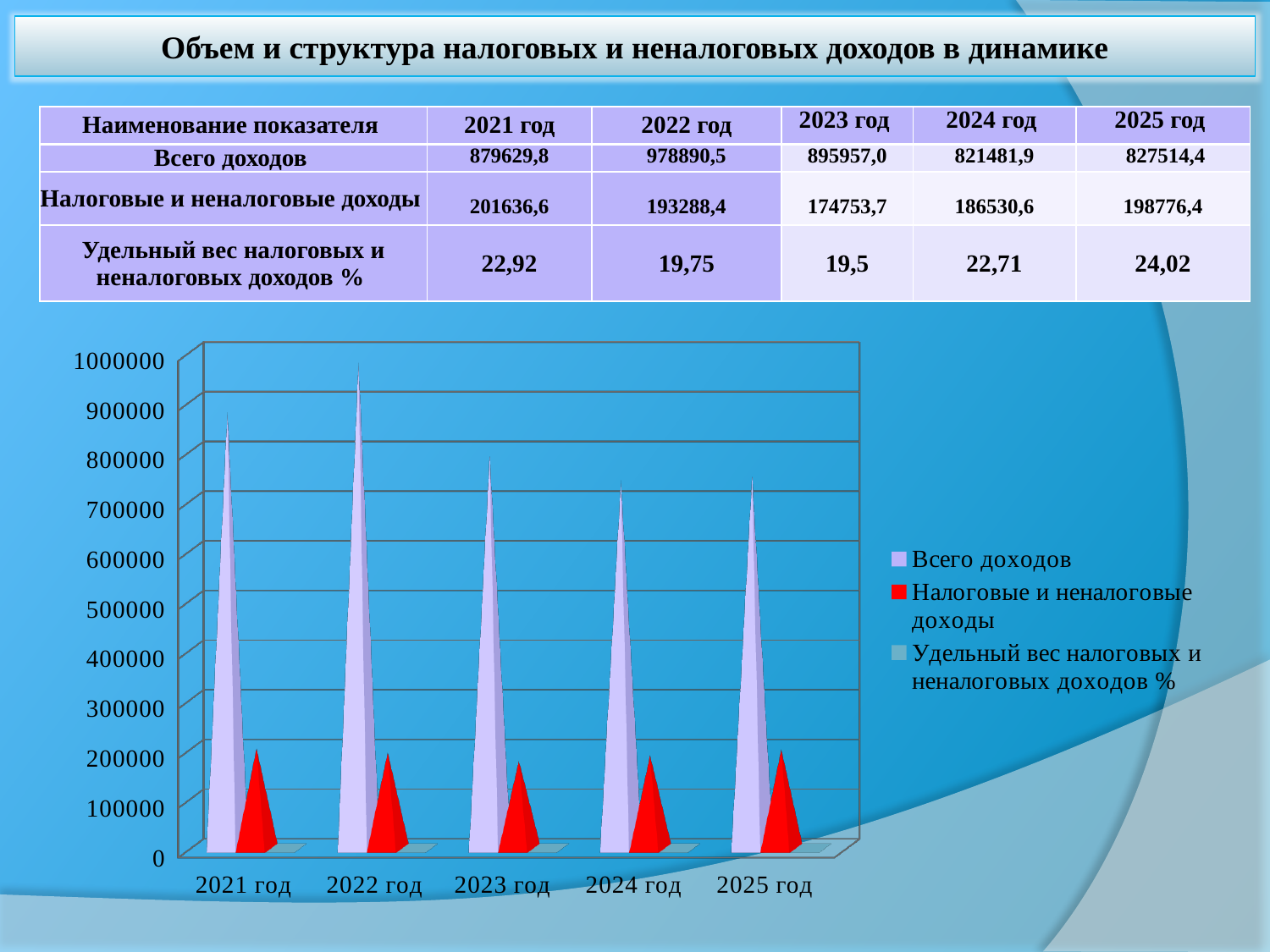
What is the value of Налоговые и неналоговые доходы for 2025 год? 198776,4 How many series does the chart legend list? 3 Which year has the lowest value for Налоговые и неналоговые доходы? 2023 год What is the difference between Всего доходов in 2022 год and in 2021 год? 99260,7 Which is larger: Всего доходов in 2021 год or in 2024 год? 2021 год What is the value of Всего доходов for 2022 год? 978890,5 From 2023 год to 2025 год, do the values for Налоговые и неналоговые доходы rise or fall? rise How many years (categories) are shown along the x axis of the chart? 5 What kind of chart is shown on the slide? bar chart Which year has the highest value for Всего доходов? 2022 год Is the value of Налоговые и неналоговые доходы for 2023 год greater or less than 200000? less